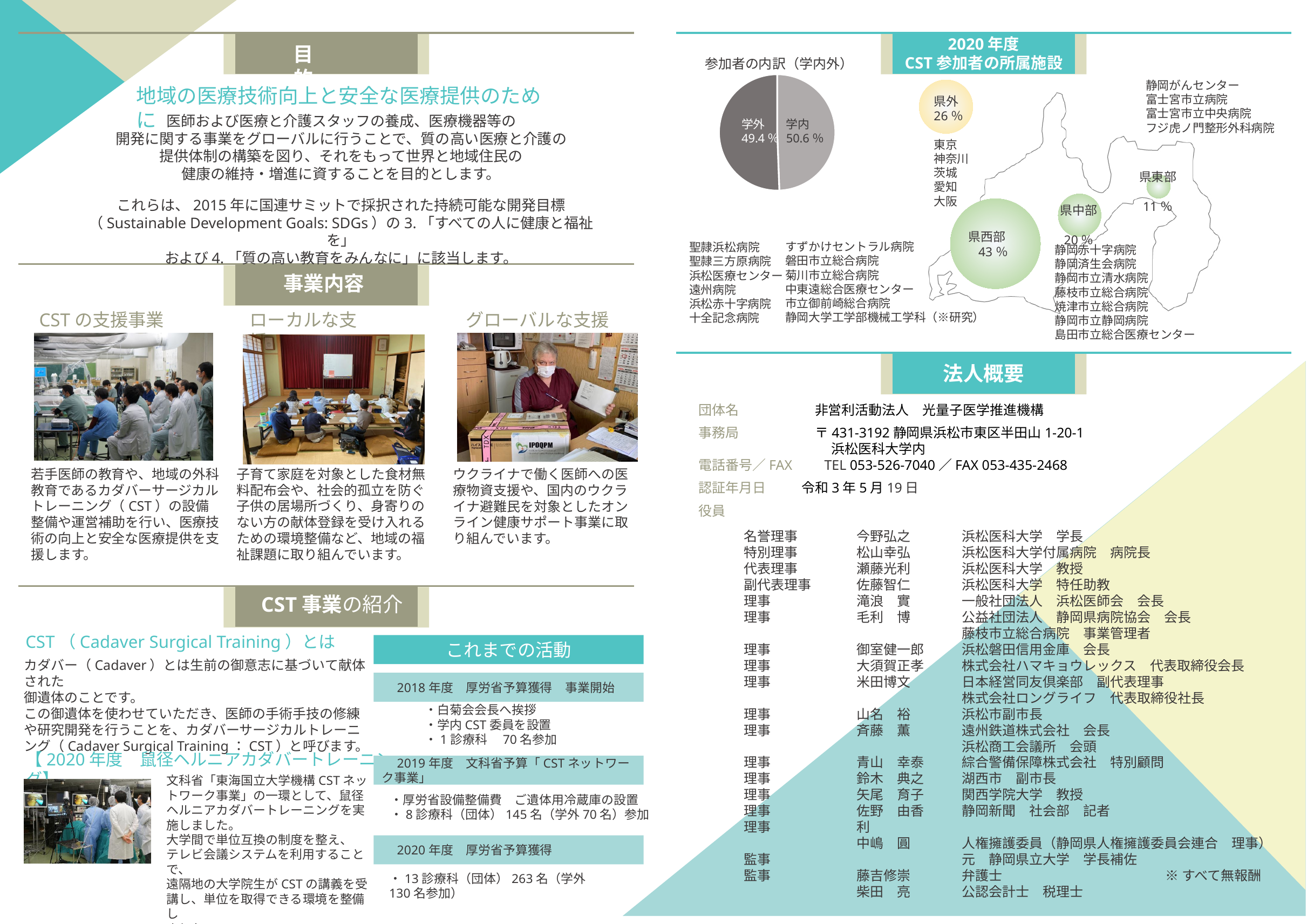
In the bubble map titled 2020 年度 CST 参加者の所属施設, which region has the lowest share? 県東部 In the bubble map titled 2020 年度 CST 参加者の所属施設, what is the value for 県西部? 43 % How many slices does the pie chart titled 参加者の内訳（学内外） have? 2 In the bubble map titled 2020 年度 CST 参加者の所属施設, what is the value for 県外? 26 % In the pie chart titled 参加者の内訳（学内外）, what is the value for 学内? 50.6 % In the pie chart titled 参加者の内訳（学内外）, what is the value for 学外? 49.4 % What kind of chart is the one titled 参加者の内訳（学内外）? pie chart In the pie chart titled 参加者の内訳（学内外）, which slice is larger, 学内 or 学外? 学内 In the pie chart titled 参加者の内訳（学内外）, what is the difference between the 学内 and 学外 shares? 1.2 % In the bubble map titled 2020 年度 CST 参加者の所属施設, which region has the highest share? 県西部 In the bubble map titled 2020 年度 CST 参加者の所属施設, what is the difference between the shares for 県西部 and 県中部? 23 % In the pie chart titled 参加者の内訳（学内外）, is the value for 学内 greater or less than 50 %? greater